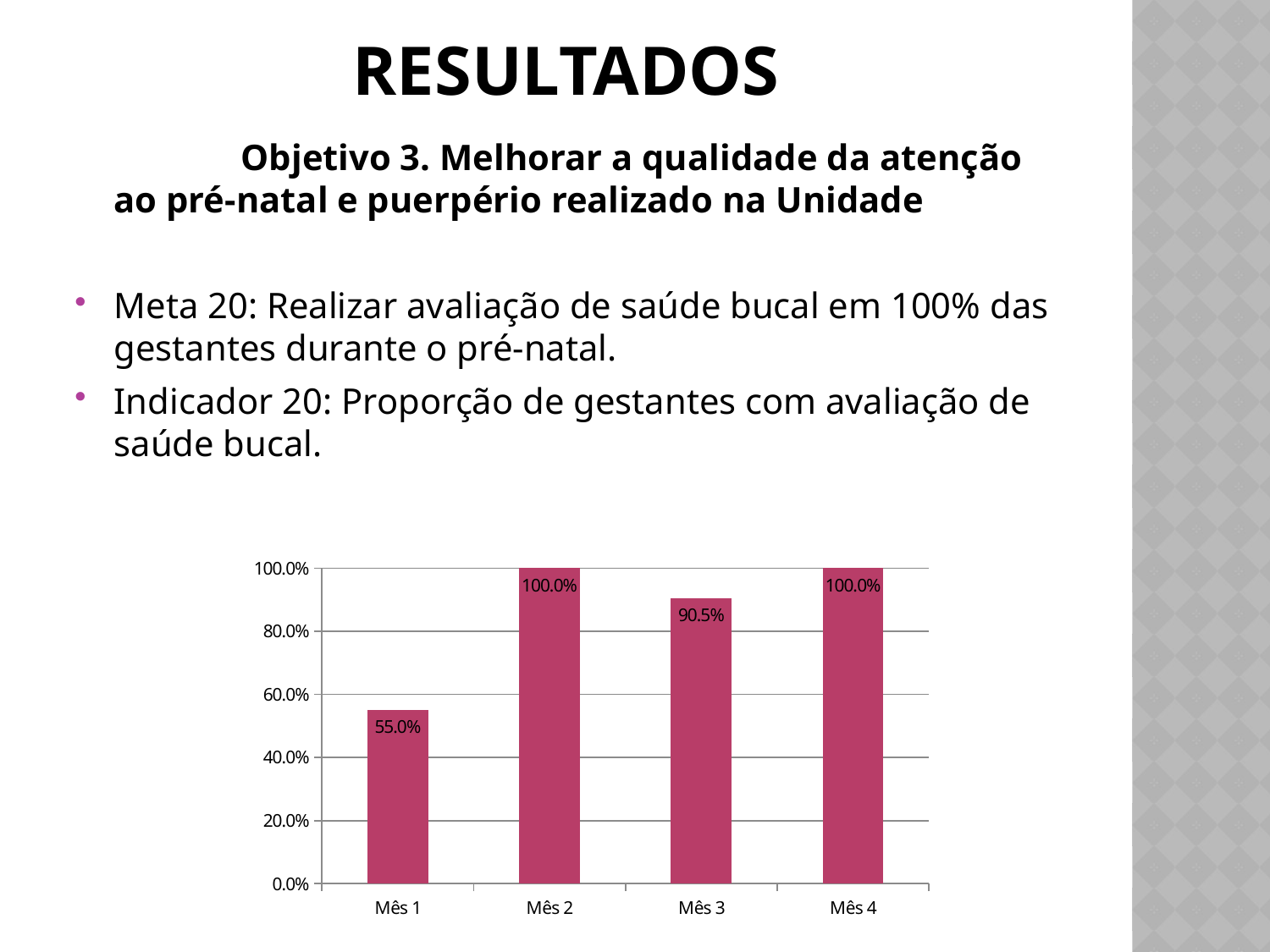
What is the value for Mês 2? 100.0% What kind of chart is shown on the slide? bar chart Which is larger, the value for Mês 3 or the value for Mês 4? Mês 4 What is the value for Mês 3? 90.5% Which months reach 100.0%? Mês 2 and Mês 4 What is the difference between the values for Mês 3 and Mês 1? 35.5% What is the value for Mês 1? 55.0% How many months are shown on the x axis? 4 Is the value for Mês 1 greater or less than 60.0%? less Is the value for Mês 3 greater or less than 80.0%? greater Which month has the lowest value? Mês 1 What is the difference between the values for Mês 2 and Mês 1? 45.0%